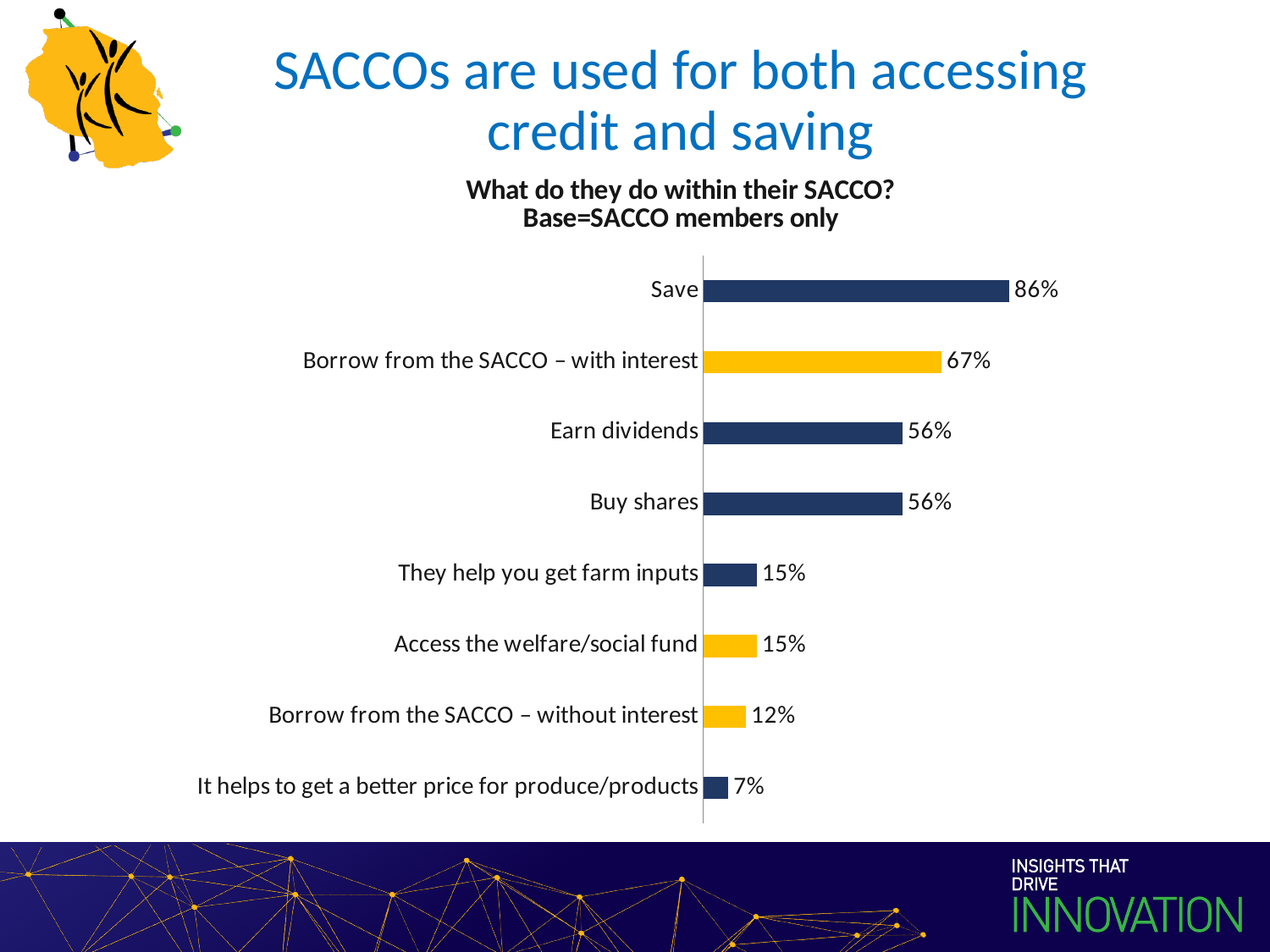
What is the difference between the percentage for 'Save' and the percentage for 'Borrow from the SACCO – with interest'? 19% Which activity has the lowest percentage in the chart? It helps to get a better price for produce/products Which activity has the highest percentage in the chart? Save What type of chart is shown on the slide? Bar chart What is the base (population) stated in the chart subtitle? SACCO members only What is the value for 'Borrow from the SACCO – with interest'? 67% What percentage of SACCO members say they save within their SACCO? 86% What percentage of SACCO members say they earn dividends? 56% What is the value for 'Borrow from the SACCO – without interest'? 12% What is the difference between 'Borrow from the SACCO – with interest' and 'Borrow from the SACCO – without interest'? 55% How many activities (categories) are shown in the chart? 8 Which is larger: the value for 'Buy shares' or the value for 'They help you get farm inputs'? Buy shares